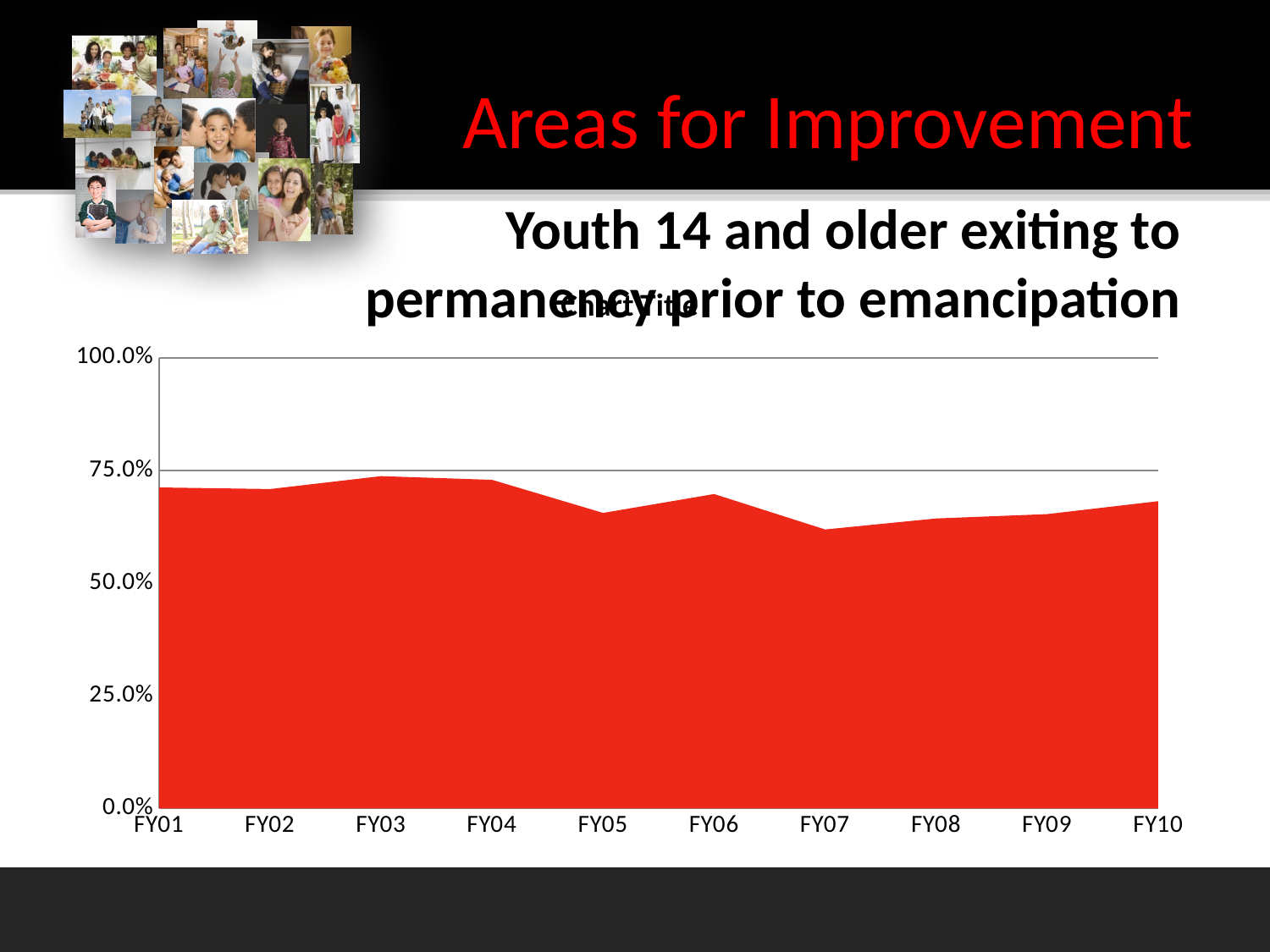
Is the value for FY10 greater or less than 50%? greater How many fiscal years are plotted along the x axis? 10 Is the value for FY01 greater or less than 50%? greater Which is larger, the value for FY03 or the value for FY07? FY03 Is the value for FY03 greater or less than 75%? less What kind of chart is shown on the slide? area chart Which is larger, the value for FY06 or the value for FY07? FY06 Which fiscal year has the lowest value? FY07 Do the values rise or fall from FY03 to FY07? fall Which is larger, the value for FY10 or the value for FY07? FY10 Do the values rise or fall from FY07 to FY10? rise